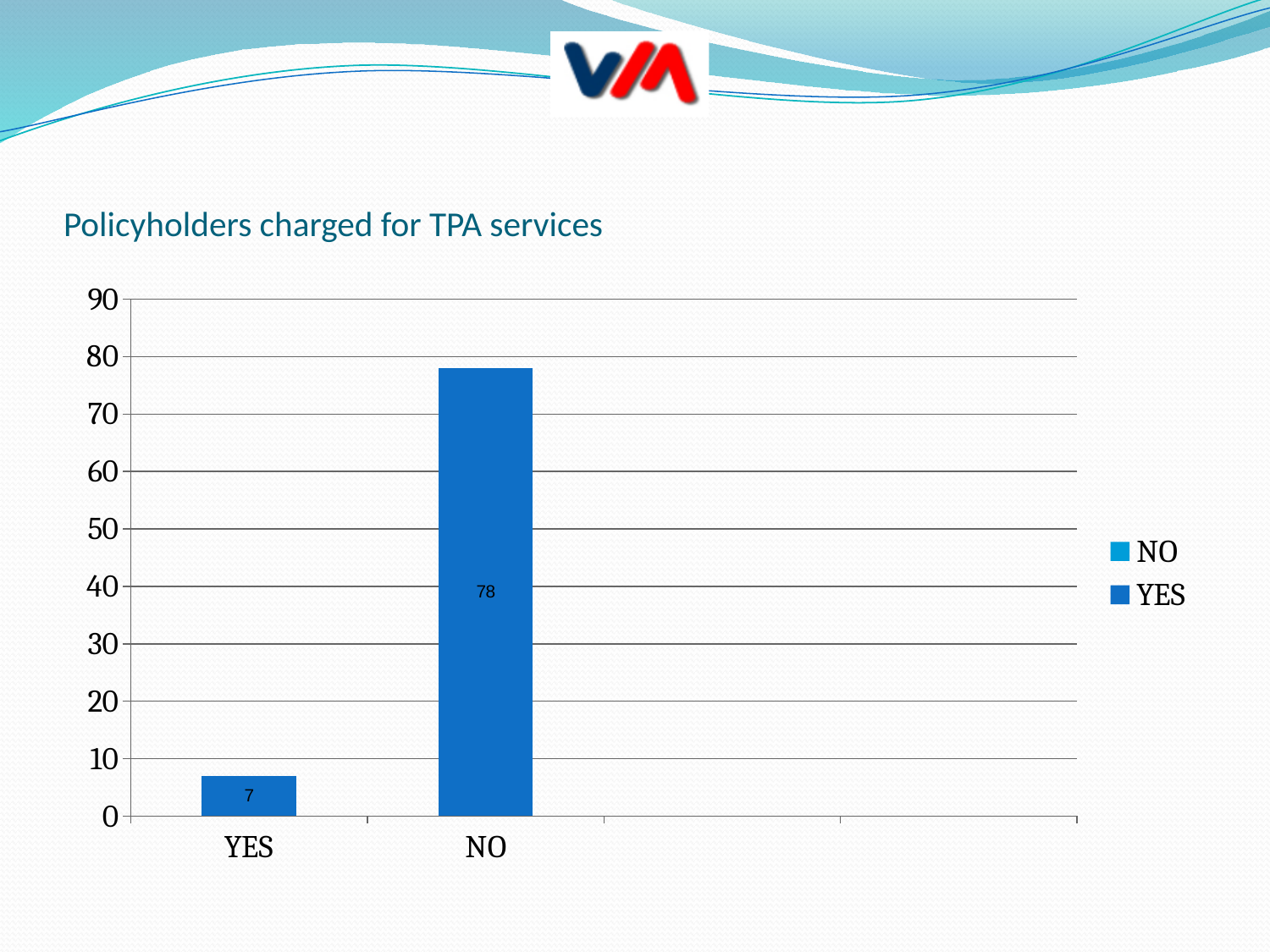
What is the value for NO? 78 Which category has the lowest value? YES What is the value for YES? 7 Is the value for YES greater or less than 10? less Which category has the highest value? NO How many entries does the legend list? 2 What is the title of the slide above the chart? Policyholders charged for TPA services What is the difference between the values for NO and YES? 71 Is the value for NO greater or less than 70? greater What kind of chart is shown on the slide? bar chart How many categories are shown on the x axis? 2 Which is larger, the value for YES or the value for NO? NO